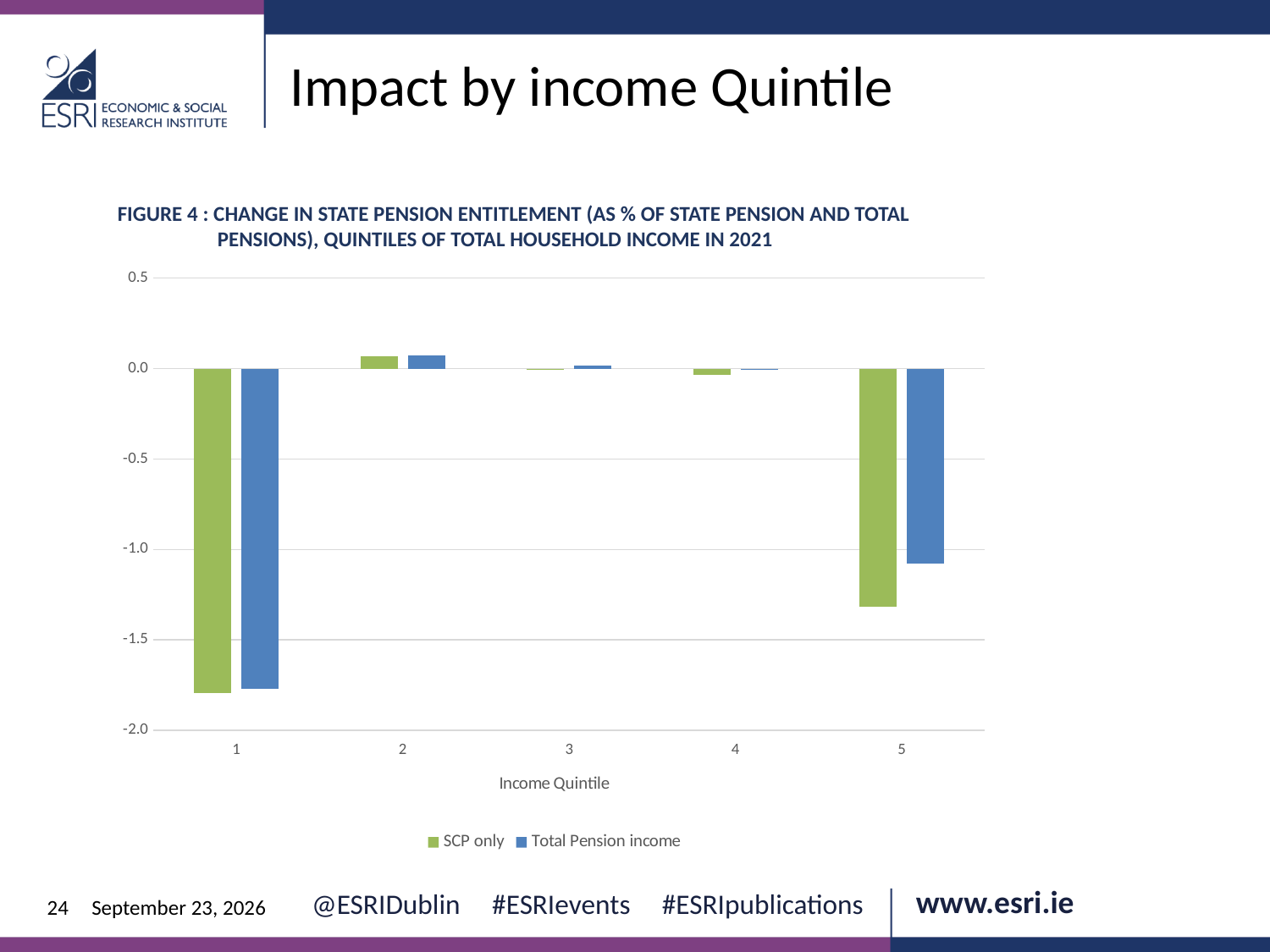
How many series does the chart's legend list? 2 Which income quintile has the lowest value for SCP only? 1 For income quintile 5, which is larger: the SCP only value or the Total Pension income value? Total Pension income Is the SCP only value for income quintile 1 greater or less than -1.5? less What kind of chart is shown on the slide? bar chart Is the Total Pension income value for income quintile 5 greater or less than -0.5? less Which income quintile has the lowest value for Total Pension income? 1 What are the two series named in the chart's legend? SCP only and Total Pension income What is the title of the x axis of the chart? Income Quintile Is the SCP only value for income quintile 5 greater or less than -1.0? less How many income quintiles are shown on the x axis of the chart? 5 Which income quintile has the highest value for SCP only? 2